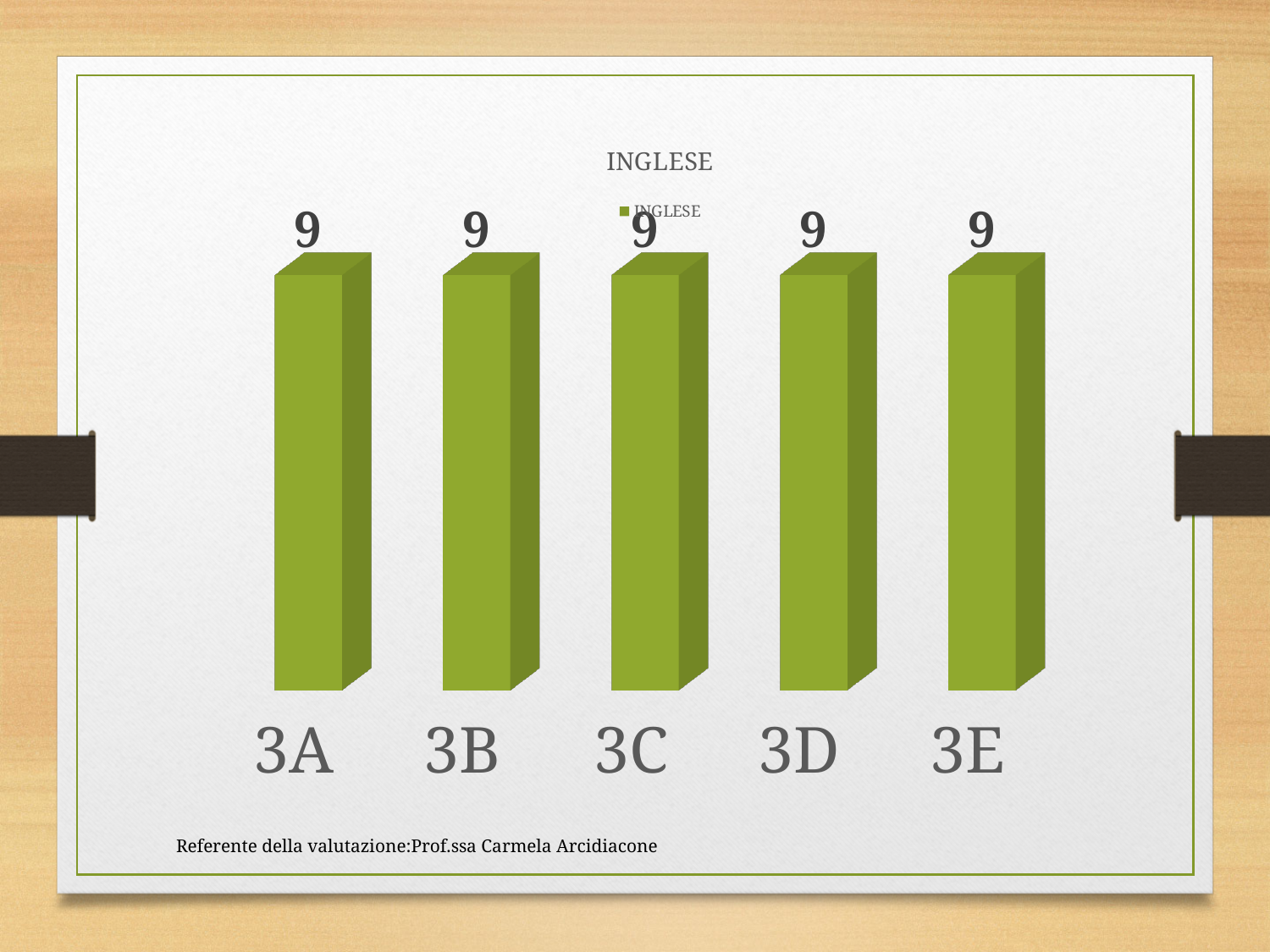
How many categories are shown on the x axis? 5 What is the name of the series listed in the legend? INGLESE What is the value for 3E? 9 How many series does the legend list? 1 What is the title of the chart? INGLESE What is the value for 3C? 9 What kind of chart is shown? bar chart Do the values rise, fall, or stay the same from 3A to 3E? stay the same What is the value for 3A? 9 What is the difference between the values for 3B and 3D? 0